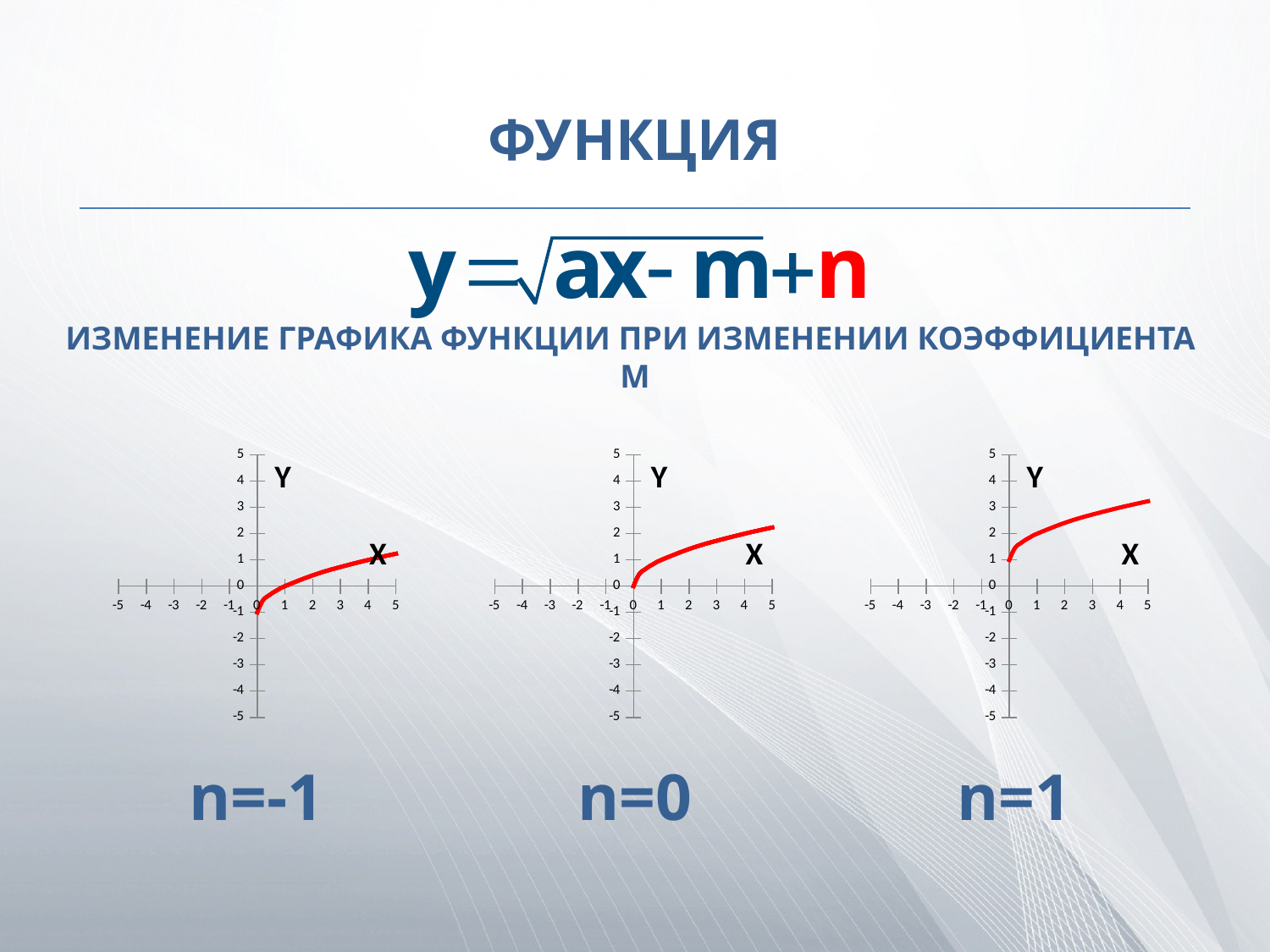
In the n=-1 chart, at what y value does the red curve meet the y axis? -1 In the n=1 chart, at what y value does the red curve meet the y axis? 1 What colour is the plotted curve in the three charts? red At x=4, which chart shows the higher curve value: the n=-1 chart or the n=1 chart? n=1 What kind of chart is shown in each of the three panels (n=-1, n=0, n=1)? line chart In the n=1 chart, is the value of the curve at x=1 greater or less than 1? greater In the n=-1 chart, is the value of the curve at x=4 greater or less than 2? less In the n=0 chart, at what y value does the red curve start on the y axis? 0 What is the highest tick value shown on the x axis of the n=0 chart? 5 In the n=0 chart, is the value of the curve at x=4 greater or less than 3? less How many charts are shown on the slide? 3 In the n=1 chart, do the values of the red curve rise or fall as x increases? rise